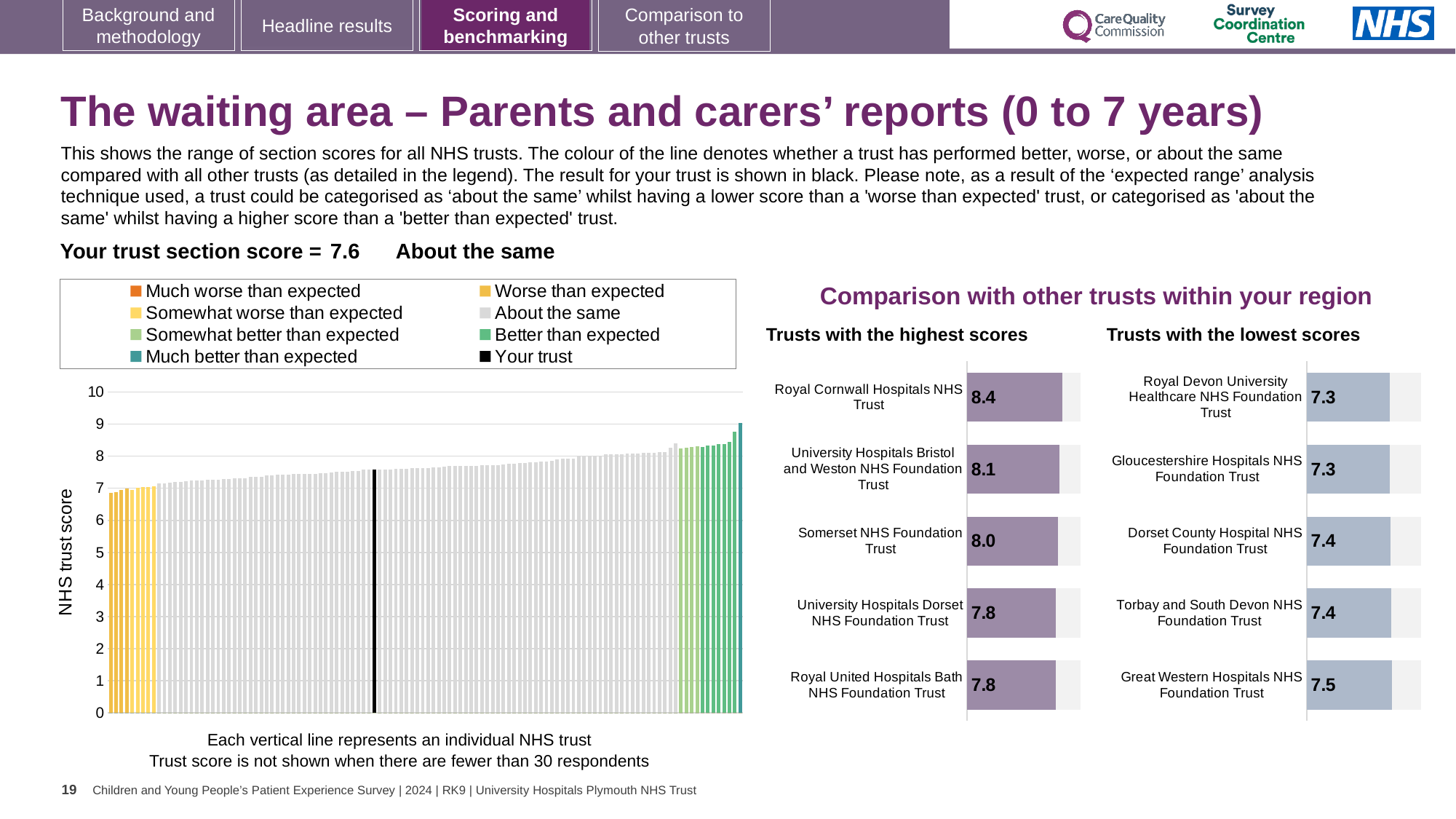
On the 'Trusts with the highest scores' chart, what is the difference between the scores of Royal Cornwall Hospitals NHS Trust and Somerset NHS Foundation Trust? 0.4 On the main chart of NHS trust scores, is the value of the tallest bar greater or less than 8? greater How many trusts are shown on the 'Trusts with the lowest scores' chart? 5 On the 'Trusts with the highest scores' chart, which has the larger score: Somerset NHS Foundation Trust or University Hospitals Dorset NHS Foundation Trust? Somerset NHS Foundation Trust On the main chart of NHS trust scores, how many entries does the legend list? 8 On the 'Trusts with the highest scores' chart, which trust has the highest score? Royal Cornwall Hospitals NHS Trust On the 'Trusts with the lowest scores' chart, what is the score for Great Western Hospitals NHS Foundation Trust? 7.5 On the main chart of NHS trust scores, what colour is used for 'Your trust' in the legend? Black What kind of chart is the main chart showing the NHS trust scores? Bar chart On the main chart of NHS trust scores, do the bars rise or fall from left to right? Rise On the 'Trusts with the lowest scores' chart, which trust has the highest score shown? Great Western Hospitals NHS Foundation Trust On the 'Trusts with the highest scores' chart, what is the score for Royal Cornwall Hospitals NHS Trust? 8.4